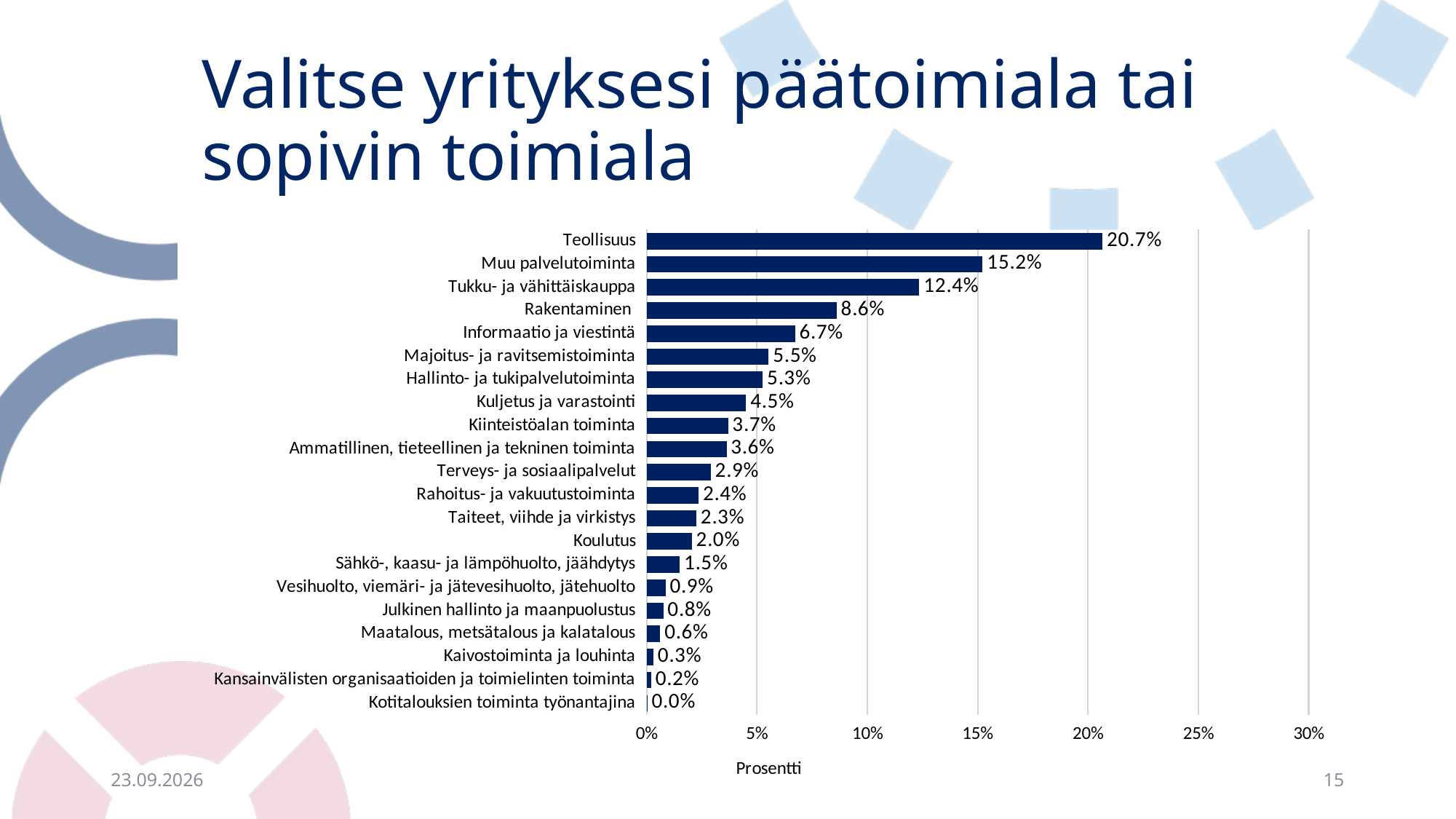
Is the value for Muu palvelutoiminta greater or less than 10%? greater Which category has the lowest value? Kotitalouksien toiminta työnantajina What is the value for Teollisuus? 20.7% What is the value for Rakentaminen? 8.6% What is the value for Koulutus? 2.0% Which category has the highest value? Teollisuus What is the value for Kaivostoiminta ja louhinta? 0.3% What kind of chart is shown on the slide? Bar chart Which is larger, the value for Tukku- ja vähittäiskauppa or the value for Rakentaminen? Tukku- ja vähittäiskauppa How many categories are shown in the chart? 21 What is the label of the horizontal axis? Prosentti What is the difference between the values for Teollisuus and Muu palvelutoiminta? 5.5 percentage points